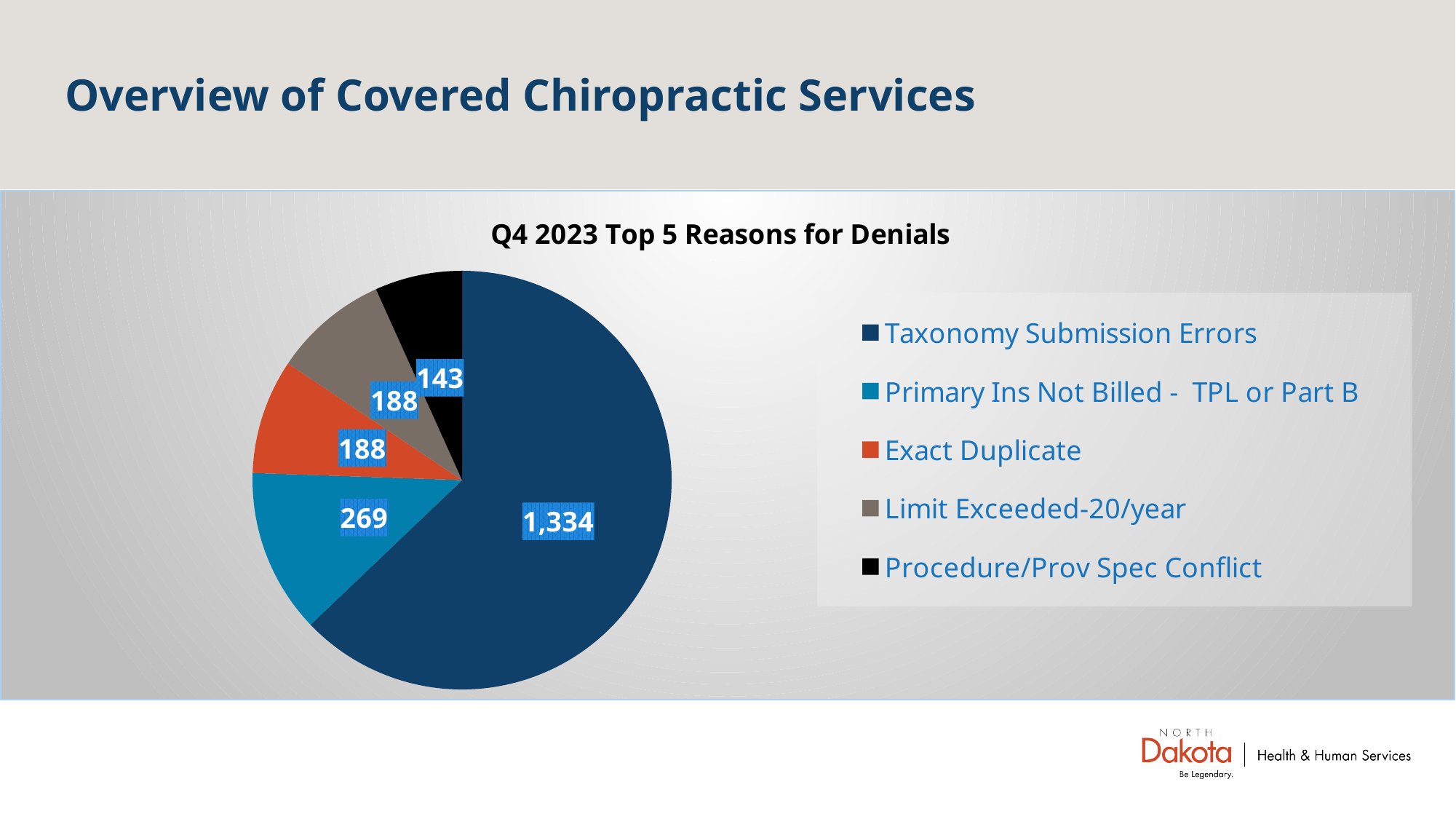
What is the value for Procedure/Prov Spec Conflict? 143 What is the value for Primary Ins Not Billed - TPL or Part B? 269 What kind of chart is shown on the slide? Pie chart Which is larger, the value for Primary Ins Not Billed - TPL or Part B or the value for Exact Duplicate? Primary Ins Not Billed - TPL or Part B Which denial reason has the lowest value? Procedure/Prov Spec Conflict How many denial reasons are shown in the pie chart? 5 Which denial reason has the highest value? Taxonomy Submission Errors What is the value for Exact Duplicate? 188 What is the difference between the values for Taxonomy Submission Errors and Primary Ins Not Billed - TPL or Part B? 1,065 What is the difference between the values for Limit Exceeded-20/year and Procedure/Prov Spec Conflict? 45 What is the value for Taxonomy Submission Errors in the Q4 2023 Top 5 Reasons for Denials chart? 1,334 What is the title of the chart? Q4 2023 Top 5 Reasons for Denials